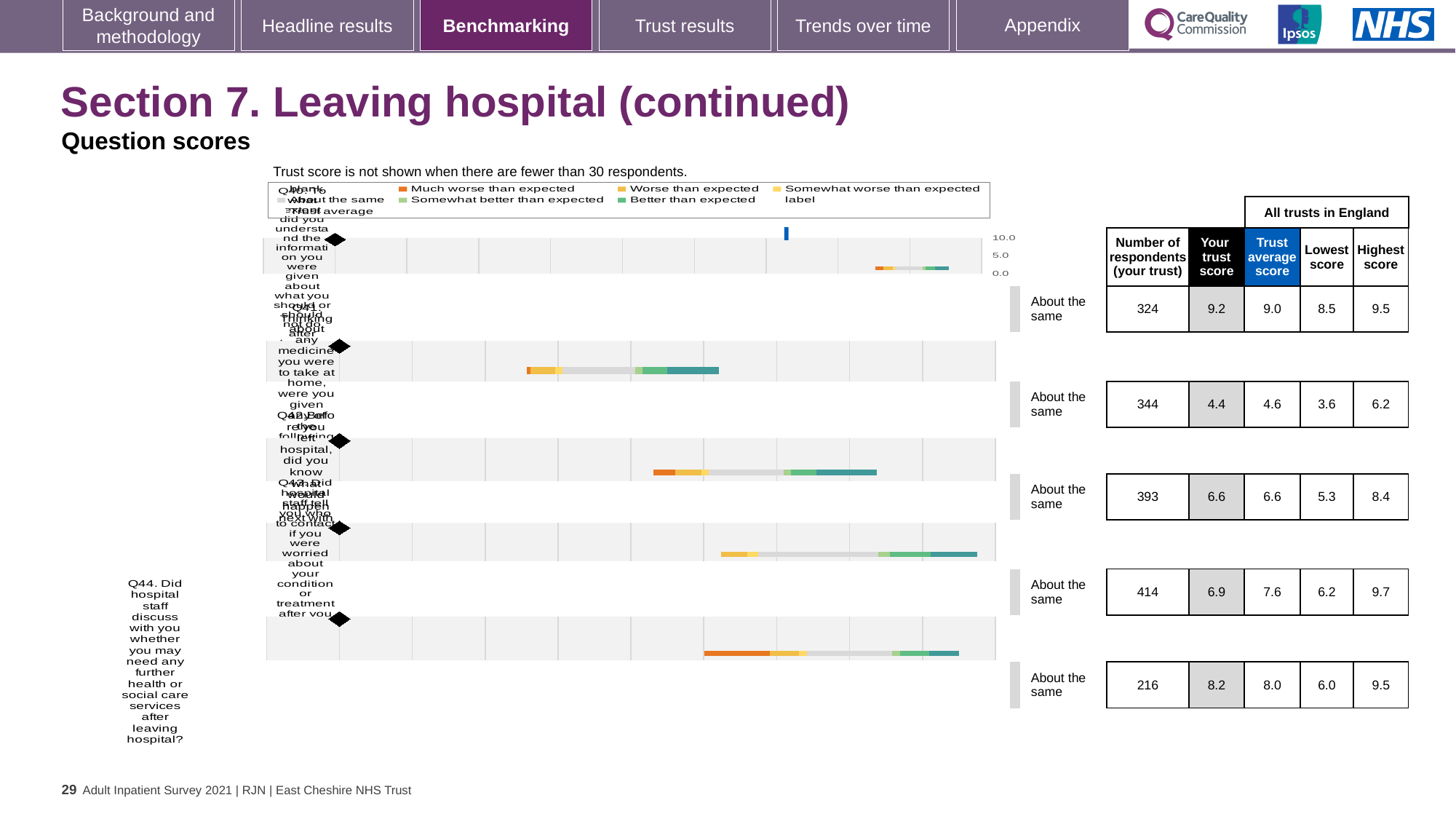
What is the highest 'Your trust score' value shown in the table? 9.2 What is the lowest 'Your trust score' value shown in the table? 4.4 How many respondents from your trust answered Q44? 216 What is the trust average score for Q44? 8.0 For Q44, which is larger: your trust score or the trust average score? Your trust score For Q44, what is the difference between the highest score and the lowest score across all trusts in England? 3.5 What is the 'Your trust score' for Q44 (Did hospital staff discuss with you whether you may need any further health or social care services after leaving hospital?)? 8.2 What is the highest score across all trusts in England for Q44? 9.5 What type of chart is used to show the question scores on this slide? Bar chart What benchmark category label is shown next to every question row on this slide? About the same How many question rows are shown in the chart and table on this slide? 5 How many respondents from your trust answered the question in the top row of the table? 324